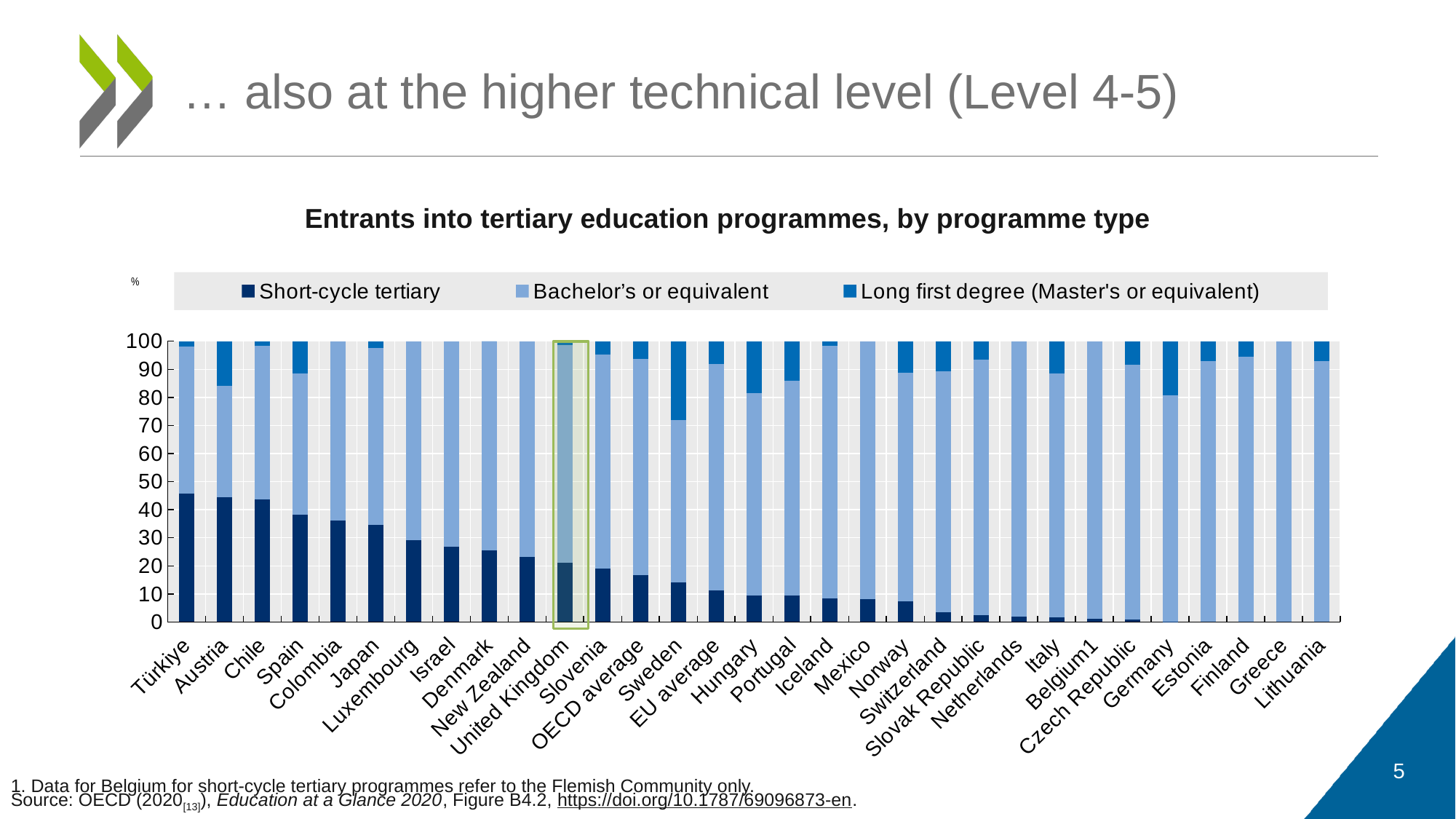
Which country's bar is highlighted with a green outline? United Kingdom How many countries or averages are shown along the x axis? 31 Is the short-cycle tertiary value for Türkiye greater or less than 40? greater Do the short-cycle tertiary values rise or fall moving from left to right along the x axis? fall What kind of chart is shown on the slide? Stacked bar chart Which has a larger short-cycle tertiary share, Chile or Spain? Chile Which has a larger short-cycle tertiary share, Denmark or the United Kingdom? Denmark Is the short-cycle tertiary value for Sweden greater or less than 20? less How many series does the legend list? 3 Which country has the highest share of entrants in short-cycle tertiary programmes? Türkiye Is the short-cycle tertiary value for Japan greater or less than 30? greater Which country has the largest share of entrants in long first degree (Master's or equivalent) programmes? Sweden